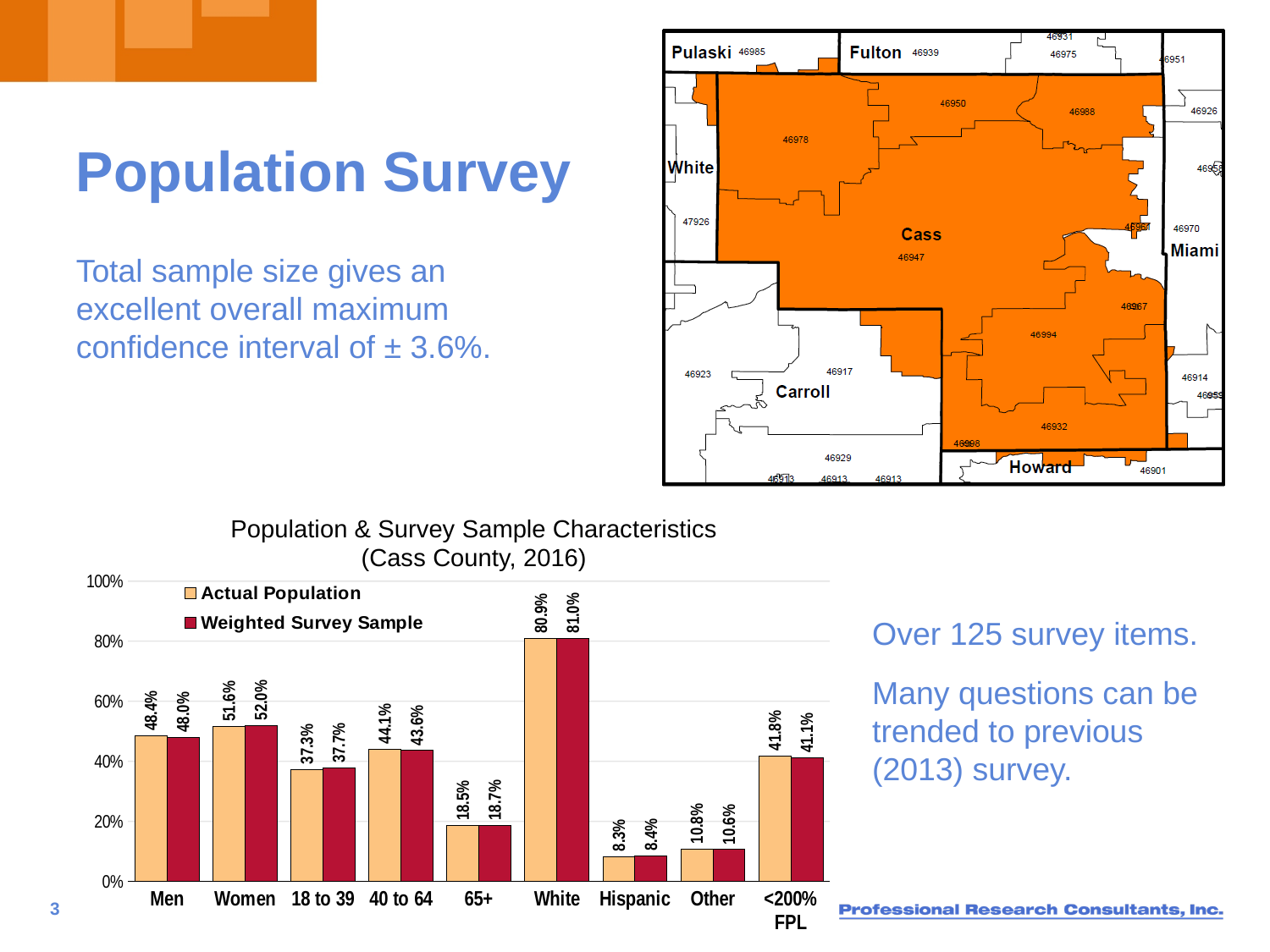
Which category has the lowest Weighted Survey Sample value? Hispanic What is the difference between the Actual Population and Weighted Survey Sample values for <200% FPL? 0.7% How many categories are shown on the x axis of the chart? 9 What is the Actual Population value for Hispanic? 8.3% What is the Weighted Survey Sample value for 18 to 39? 37.7% Which is larger for 40 to 64: the Actual Population value or the Weighted Survey Sample value? Actual Population How many series does the chart legend list? 2 Which category has the highest Actual Population value? White What is the title of the chart? Population & Survey Sample Characteristics (Cass County, 2016) What is the Actual Population value for Women? 51.6% Is the Weighted Survey Sample value for 65+ greater or less than 20%? less What kind of chart is shown on the slide? bar chart